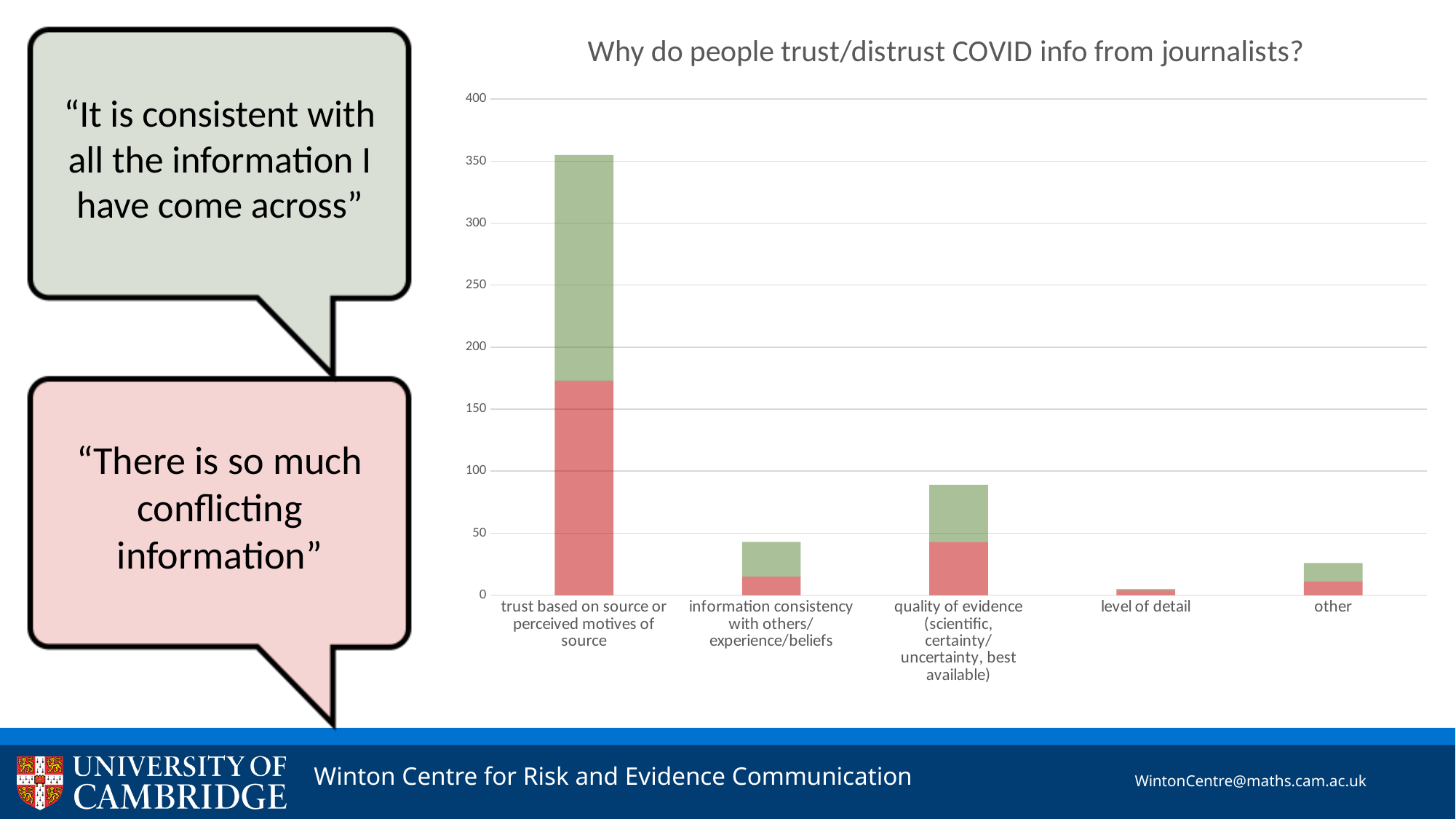
What is the title of the chart? Why do people trust/distrust COVID info from journalists? How many categories are shown on the x axis of the chart? 5 Is the red segment of the 'trust based on source or perceived motives of source' bar greater or less than 150? greater What two colours are used for the segments of the stacked bars? Red and green Which category has the shortest bar in the chart? level of detail Which category has the tallest bar in the chart? trust based on source or perceived motives of source Is the total bar height for 'information consistency with others/experience/beliefs' greater or less than 50? less Which bar is taller: 'other' or 'level of detail'? other What kind of chart is shown on the slide? Stacked bar chart Which bar is taller: 'quality of evidence' or 'information consistency with others/experience/beliefs'? quality of evidence Is the total bar height for 'quality of evidence' greater or less than 100? less